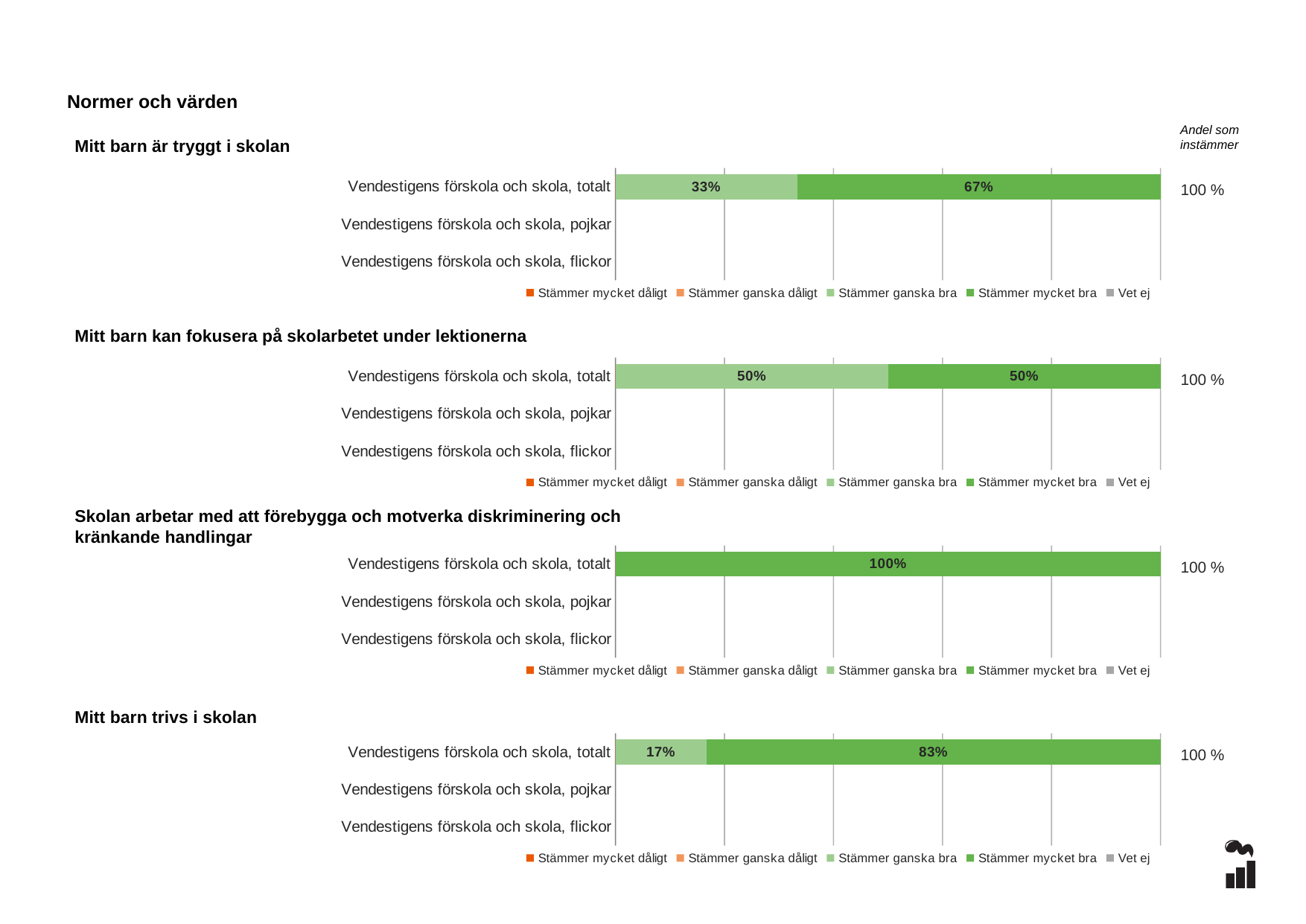
How many series does the legend list in the chart 'Mitt barn trivs i skolan'? 5 In the chart 'Mitt barn är tryggt i skolan', what is the total of the stacked bar for Vendestigens förskola och skola, totalt? 100% In the chart 'Mitt barn trivs i skolan', what is the value for 'Stämmer ganska bra' for Vendestigens förskola och skola, totalt? 17% In the chart 'Mitt barn är tryggt i skolan', what is the value for 'Stämmer mycket bra' for Vendestigens förskola och skola, totalt? 67% In the chart 'Mitt barn kan fokusera på skolarbetet under lektionerna', what is the value for 'Stämmer mycket bra' for Vendestigens förskola och skola, totalt? 50% In the chart 'Mitt barn är tryggt i skolan', which is larger for Vendestigens förskola och skola, totalt: 'Stämmer ganska bra' or 'Stämmer mycket bra'? Stämmer mycket bra In the chart 'Skolan arbetar med att förebygga och motverka diskriminering och kränkande handlingar', what is the value for 'Stämmer mycket bra' for Vendestigens förskola och skola, totalt? 100% In the chart 'Mitt barn trivs i skolan', what is the difference between the 'Stämmer mycket bra' and 'Stämmer ganska bra' values for Vendestigens förskola och skola, totalt? 66% How many categories are shown on the y axis of the chart 'Mitt barn kan fokusera på skolarbetet under lektionerna'? 3 What kind of chart is 'Mitt barn är tryggt i skolan'? Stacked bar chart In the chart 'Mitt barn trivs i skolan', what is the value for 'Stämmer mycket bra' for Vendestigens förskola och skola, totalt? 83% In the chart 'Mitt barn är tryggt i skolan', what is the value for 'Stämmer ganska bra' for Vendestigens förskola och skola, totalt? 33%